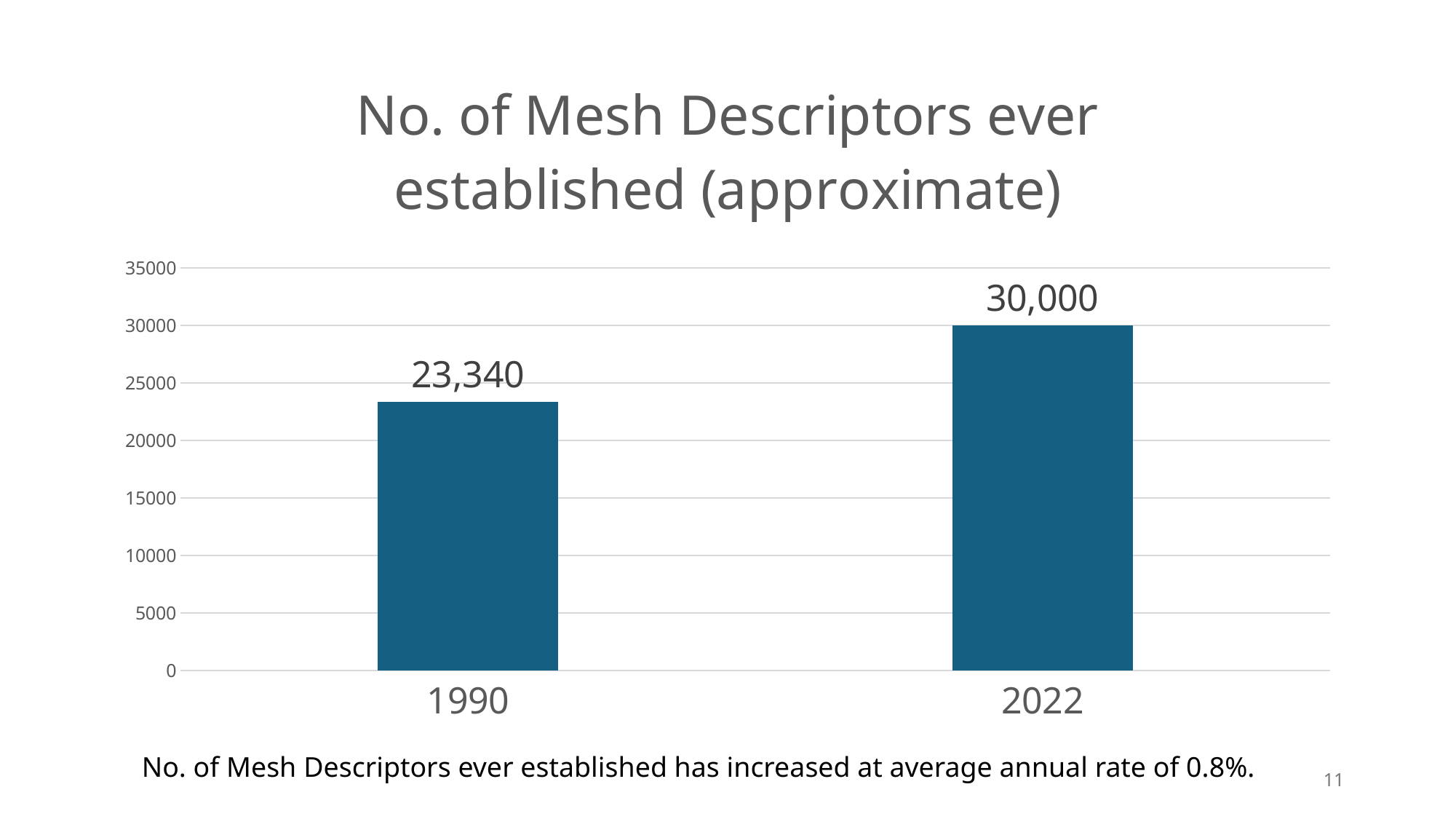
Do the values rise or fall from 1990 to 2022? rise What kind of chart is shown on the slide? bar chart Is the value for 1990 greater or less than 25000? less Is the value for 1990 larger or smaller than the value for 2022? smaller What is the title of the chart? No. of Mesh Descriptors ever established (approximate) What is the highest value shown on the y axis? 35000 Which year has the higher number of Mesh Descriptors? 2022 What is the value for 1990? 23,340 Which year has the lower number of Mesh Descriptors? 1990 What is the difference between the values for 2022 and 1990? 6,660 How many categories are shown on the x axis? 2 What is the value for 2022? 30,000